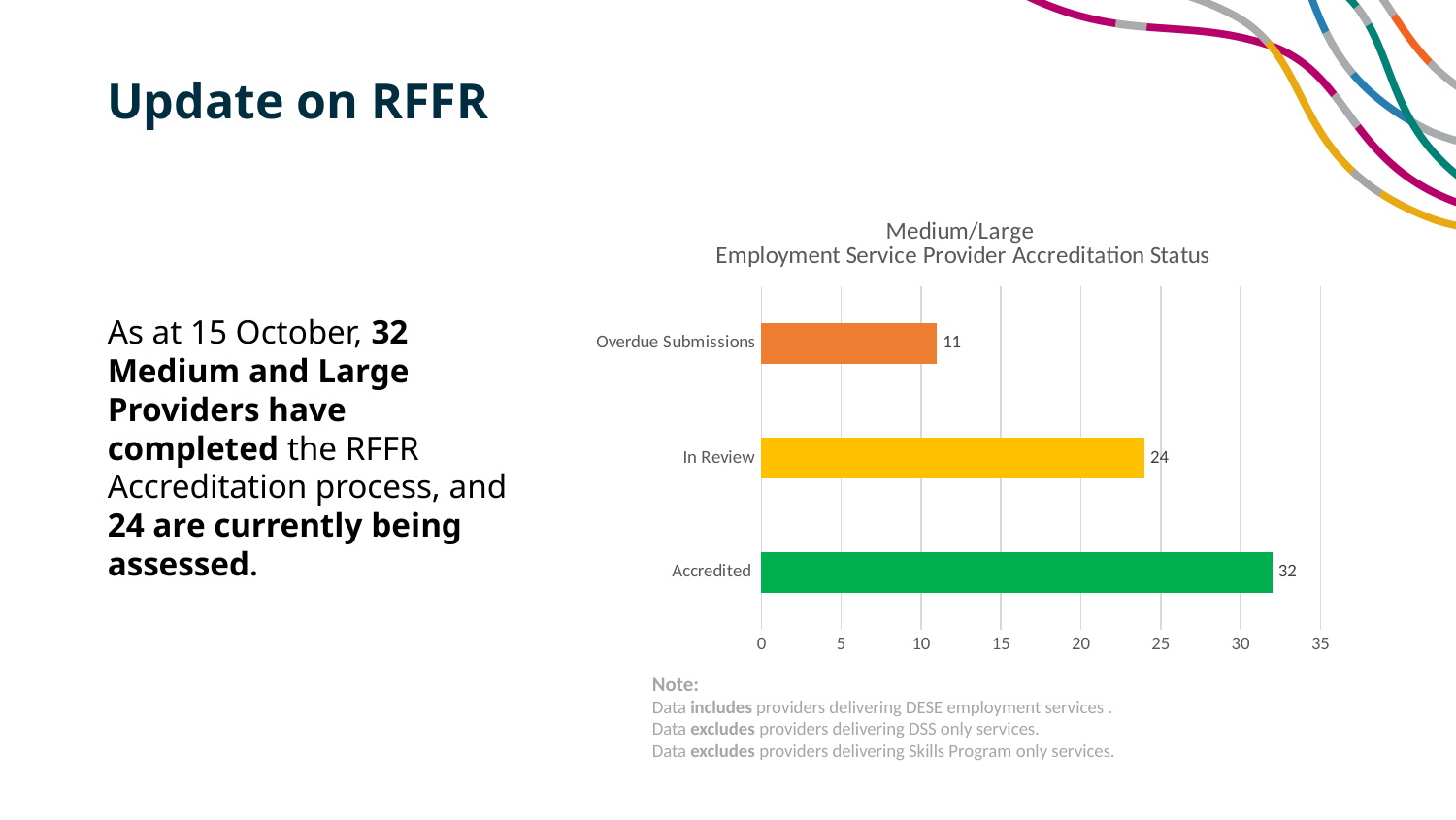
What is the value for Overdue Submissions? 11 Which is larger, the value for In Review or the value for Overdue Submissions? In Review Which category has the highest value? Accredited How many categories are shown in the chart? 3 Is the value for Accredited greater or less than 30? greater What is the title of the chart? Medium/Large Employment Service Provider Accreditation Status Which category has the lowest value? Overdue Submissions What is the difference between the values for In Review and Overdue Submissions? 13 What kind of chart is shown on the slide? bar chart What is the difference between the values for Accredited and In Review? 8 What is the value for Accredited? 32 What is the value for In Review? 24